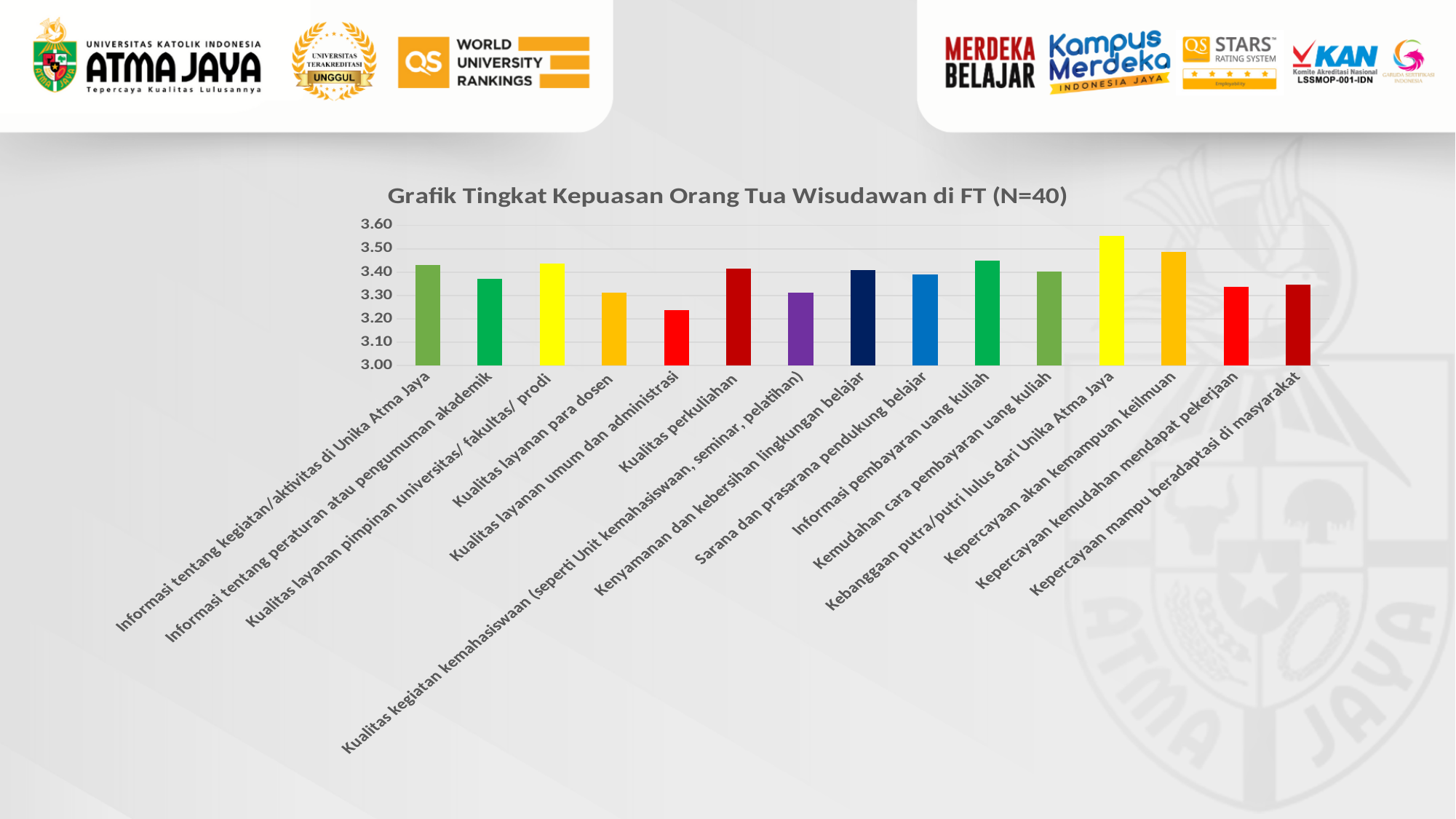
How many categories are plotted in the chart? 15 Which category has the lowest value in the chart? Kualitas layanan umum dan administrasi Is the value for Kebanggaan putra/putri lulus dari Unika Atma Jaya greater or less than 3.50? greater What type of chart is shown on the slide? Bar chart Is the value for Informasi tentang peraturan atau pengumuman akademik greater or less than 3.40? less What is the highest value shown on the vertical axis of the chart? 3.60 Which category has the highest value in the chart? Kebanggaan putra/putri lulus dari Unika Atma Jaya Which is larger: the value for Kebanggaan putra/putri lulus dari Unika Atma Jaya or the value for Kepercayaan akan kemampuan keilmuan? Kebanggaan putra/putri lulus dari Unika Atma Jaya Is the value for Informasi pembayaran uang kuliah greater or less than 3.40? greater Which is larger: the value for Kualitas layanan para dosen or the value for Kualitas layanan umum dan administrasi? Kualitas layanan para dosen What is the title of the chart? Grafik Tingkat Kepuasan Orang Tua Wisudawan di FT (N=40)